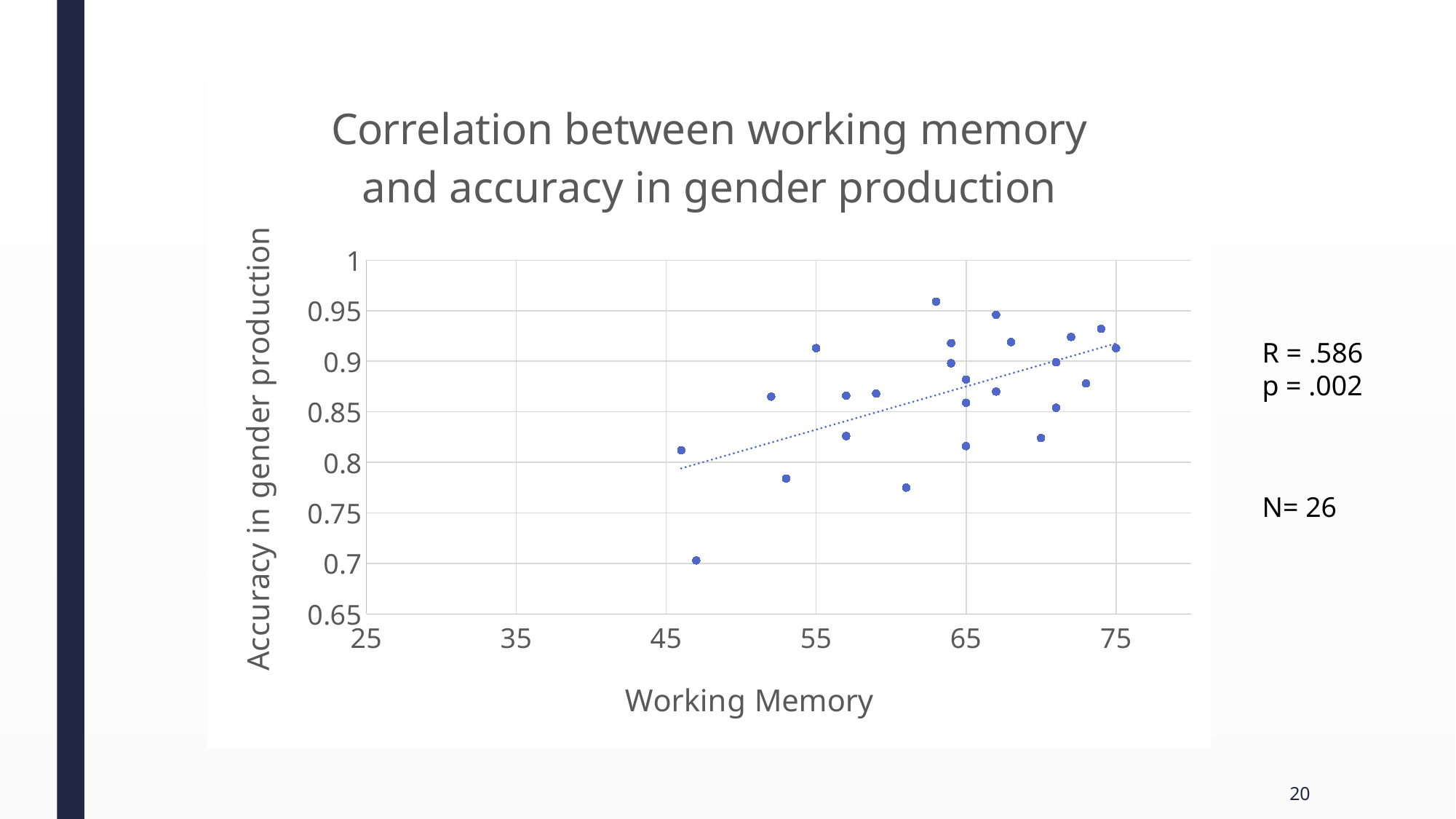
Is the accuracy value of the lowest plotted point greater or less than 0.75? less What is the lowest value shown on the y axis? 0.65 Is the working memory value of the leftmost plotted point greater or less than 45? greater What is the title of the chart? Correlation between working memory and accuracy in gender production Is the accuracy value of the highest plotted point greater or less than 0.9? greater What kind of chart is shown on the slide? scatter plot Do the accuracy values generally rise or fall as working memory increases along the x axis? rise What correlation coefficient R is reported next to the chart? .586 What is the highest value shown on the x axis? 75 What is the label of the x axis? Working Memory How many data points are plotted in the chart, according to the N shown on the slide? 26